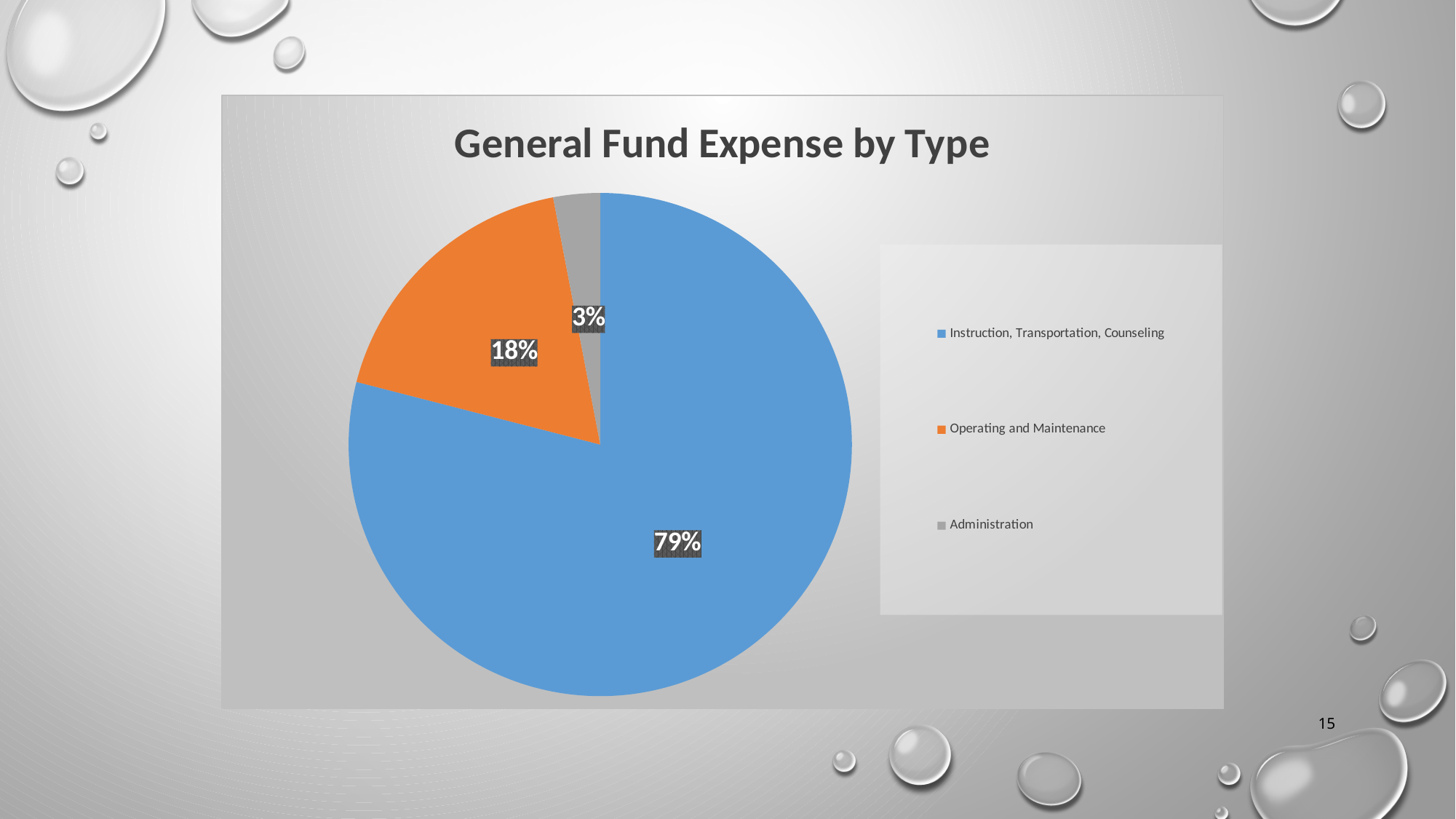
What is the title of the chart? General Fund Expense by Type What is the difference in percentage points between Instruction, Transportation, Counseling and Operating and Maintenance? 61 percentage points What share of the pie is Instruction, Transportation, Counseling? 79% Which category has the largest slice of the pie? Instruction, Transportation, Counseling What colour is the Administration slice? grey Which category has the smallest slice of the pie? Administration What share of the pie is Administration? 3% What is the difference in percentage points between Operating and Maintenance and Administration? 15 percentage points How many categories does the pie chart show? 3 What kind of chart is shown on the slide? pie chart What share of the pie is Operating and Maintenance? 18% Which is larger, the Operating and Maintenance slice or the Administration slice? Operating and Maintenance